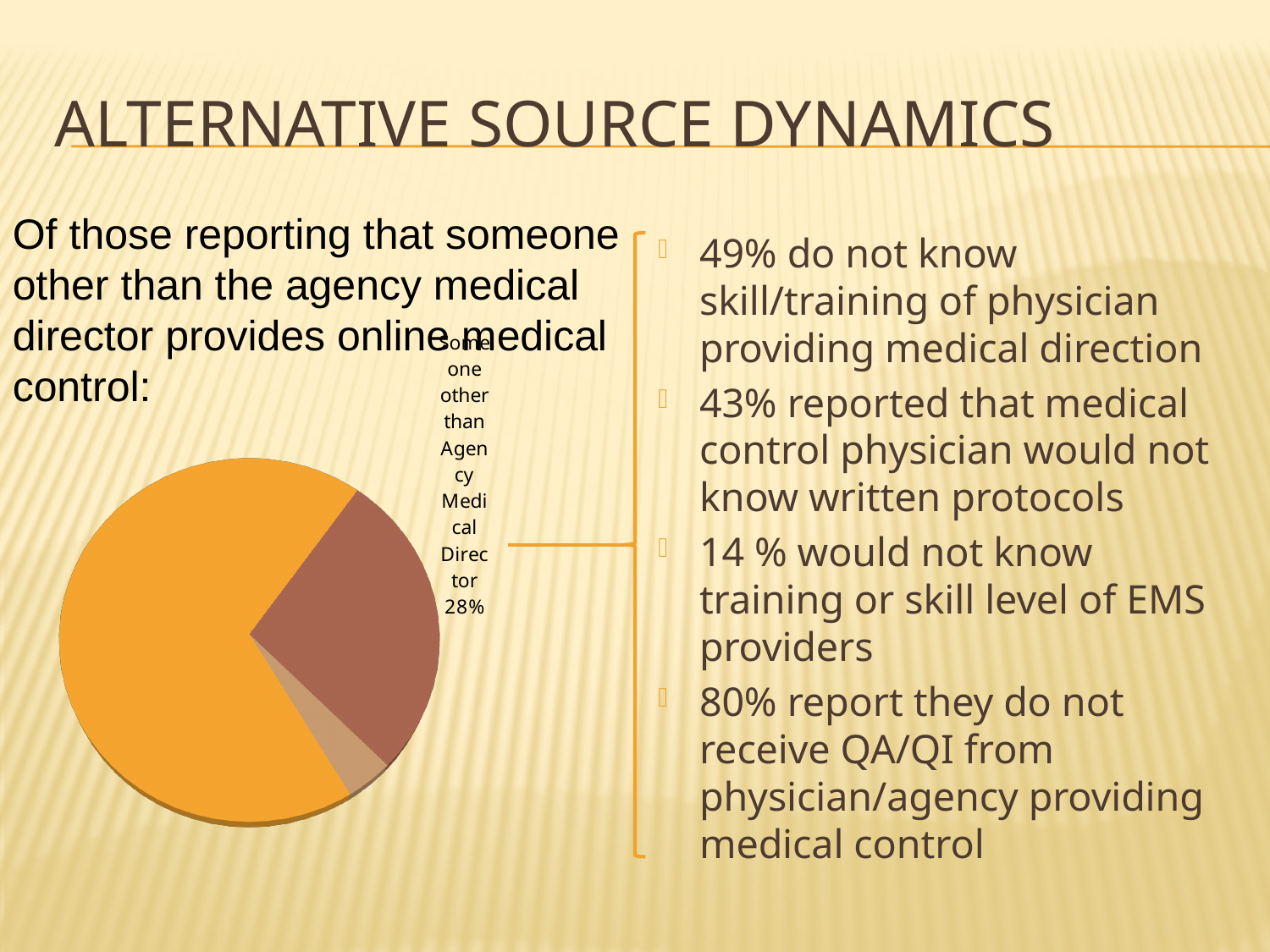
How many slices does the pie chart have? 3 Is the largest slice of the pie chart greater or less than 50% of the pie? greater Is the smallest slice of the pie chart greater or less than 25% of the pie? less Is the slice labeled 'Someone other than Agency Medical Director' larger or smaller than the orange slice? smaller What kind of chart is shown on the slide? Pie chart Is the slice labeled 'Someone other than Agency Medical Director' the largest slice of the pie? No What percentage is shown for the slice labeled 'Someone other than Agency Medical Director'? 28% What colour is the largest slice of the pie chart? Orange What colour is the slice labeled 'Someone other than Agency Medical Director 28%'? Brown